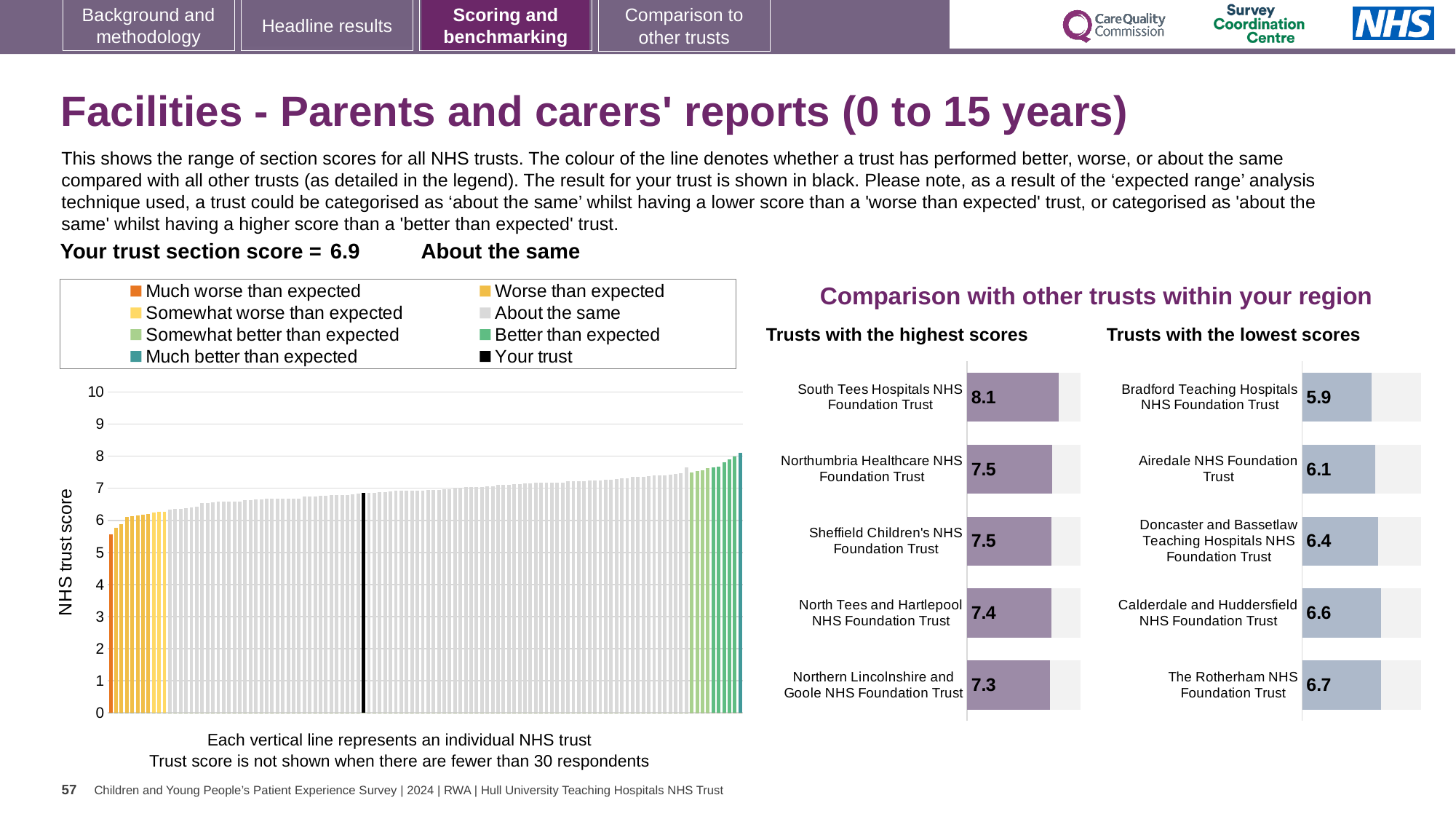
How many trusts are shown in the 'Trusts with the highest scores' chart? 5 In the 'Trusts with the lowest scores' chart, which has the higher score: Airedale NHS Foundation Trust or Doncaster and Bassetlaw Teaching Hospitals NHS Foundation Trust? Doncaster and Bassetlaw Teaching Hospitals NHS Foundation Trust In the 'Trusts with the highest scores' chart, what is the difference between the scores of South Tees Hospitals NHS Foundation Trust and Northern Lincolnshire and Goole NHS Foundation Trust? 0.8 In the 'Trusts with the highest scores' chart, which trust has the highest score? South Tees Hospitals NHS Foundation Trust In the 'Trusts with the highest scores' chart, what is the score for South Tees Hospitals NHS Foundation Trust? 8.1 In the 'Trusts with the lowest scores' chart, what is the score for Bradford Teaching Hospitals NHS Foundation Trust? 5.9 How many entries does the legend of the 'NHS trust score' chart list? 8 In the 'Trusts with the lowest scores' chart, what is the difference between the scores of The Rotherham NHS Foundation Trust and Bradford Teaching Hospitals NHS Foundation Trust? 0.8 What is your trust's section score shown on the slide? 6.9 In the 'NHS trust score' chart, is the value of the lowest (leftmost) bar greater or less than 6? less What kind of chart is the 'NHS trust score' chart on the left of the slide? Bar chart In the 'Trusts with the lowest scores' chart, which trust has the lowest score? Bradford Teaching Hospitals NHS Foundation Trust